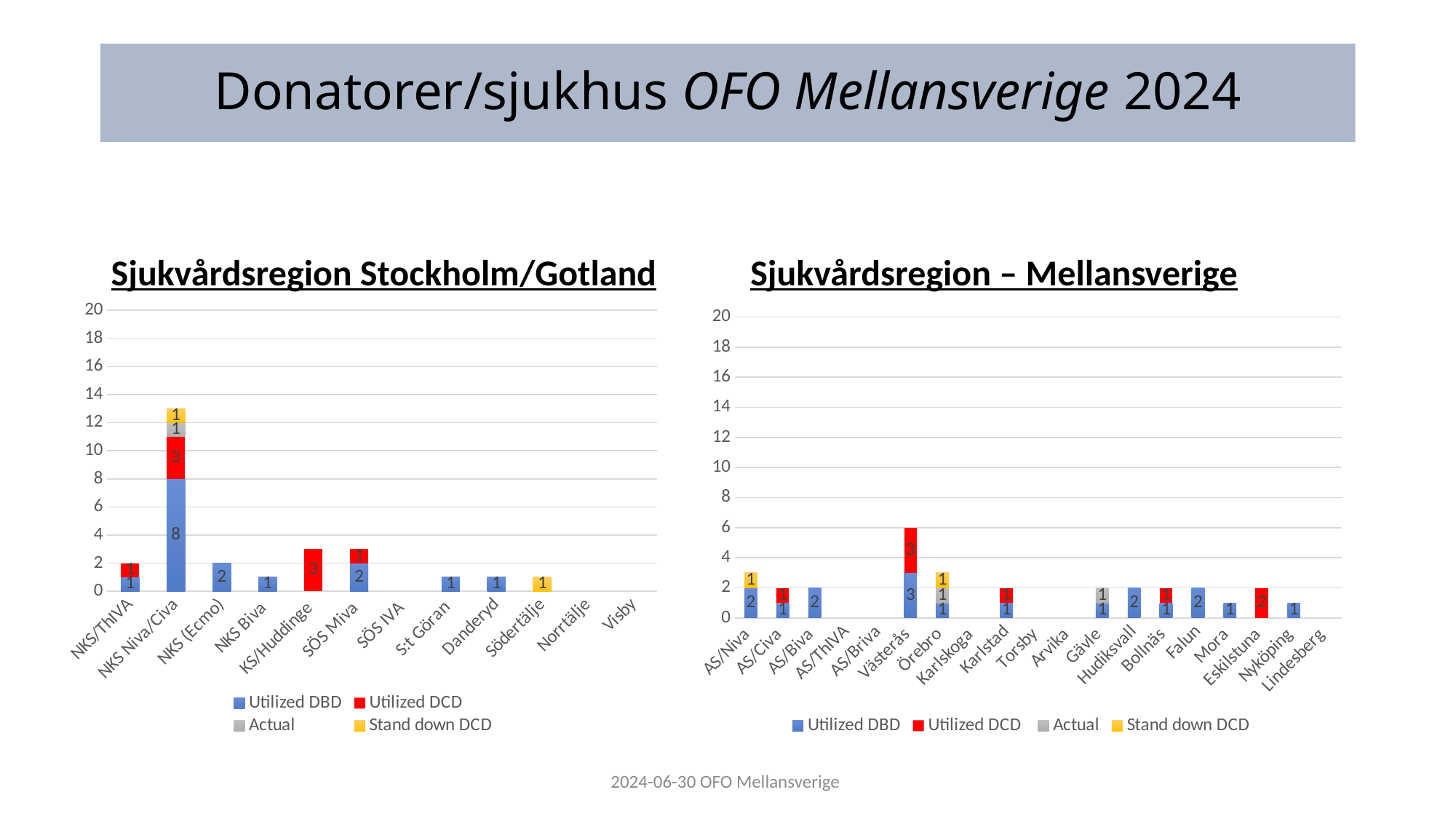
In the Sjukvårdsregion Stockholm/Gotland chart, what is the Utilized DBD value for NKS Niva/Civa? 8 In the Sjukvårdsregion Stockholm/Gotland chart, which is larger: the total bar for SÖS Miva or the total bar for NKS (Ecmo)? SÖS Miva In the Sjukvårdsregion – Mellansverige chart, what is the total height of the stacked bar for Västerås? 6 In the Sjukvårdsregion Stockholm/Gotland chart, which hospital has the highest total bar? NKS Niva/Civa In the Sjukvårdsregion Stockholm/Gotland chart, what is the total height of the stacked bar for NKS Niva/Civa? 13 What kind of chart is the Sjukvårdsregion – Mellansverige chart? Stacked bar chart In the Sjukvårdsregion – Mellansverige chart, what is the difference between the total bar for Västerås and the total bar for AS/Niva? 3 In the Sjukvårdsregion – Mellansverige chart, what is the Utilized DCD value for Eskilstuna? 2 How many series does the legend of the Sjukvårdsregion Stockholm/Gotland chart list? 4 In the Sjukvårdsregion – Mellansverige chart, which hospital has the highest total bar? Västerås In the Sjukvårdsregion – Mellansverige chart, what is the Utilized DCD value for Västerås? 3 In the Sjukvårdsregion Stockholm/Gotland chart, what is the Utilized DCD value for KS/Huddinge? 3